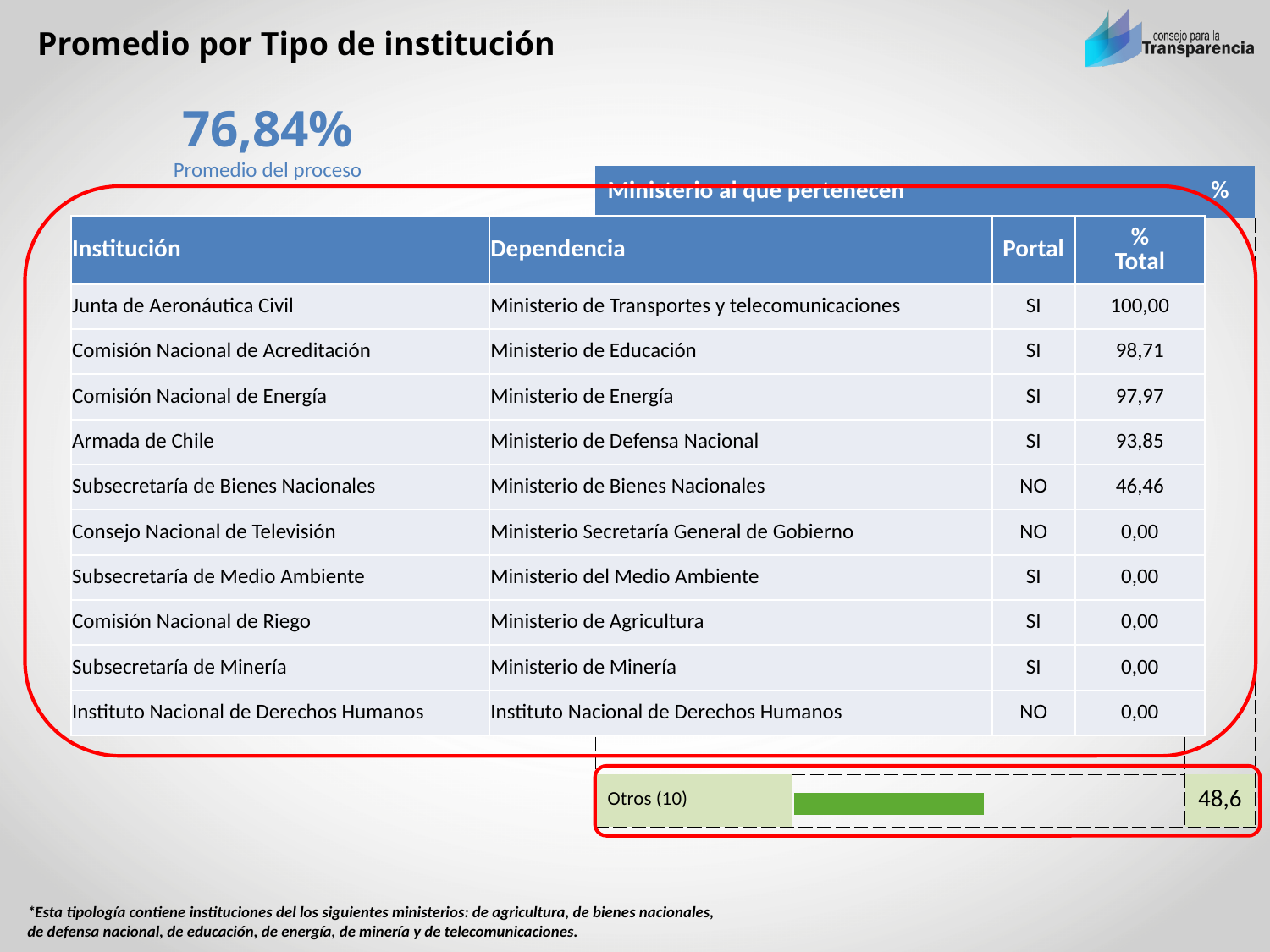
What colour is the bar for Otros (10)? green What kind of chart is shown below the table, next to the label Otros (10)? bar chart How many bars are plotted in the chart below the table? 1 What is the label of the category plotted in the bar chart below the table? Otros (10) Is the value for Otros (10) greater or less than 50? less What is the value shown for the bar labelled Otros (10)? 48,6